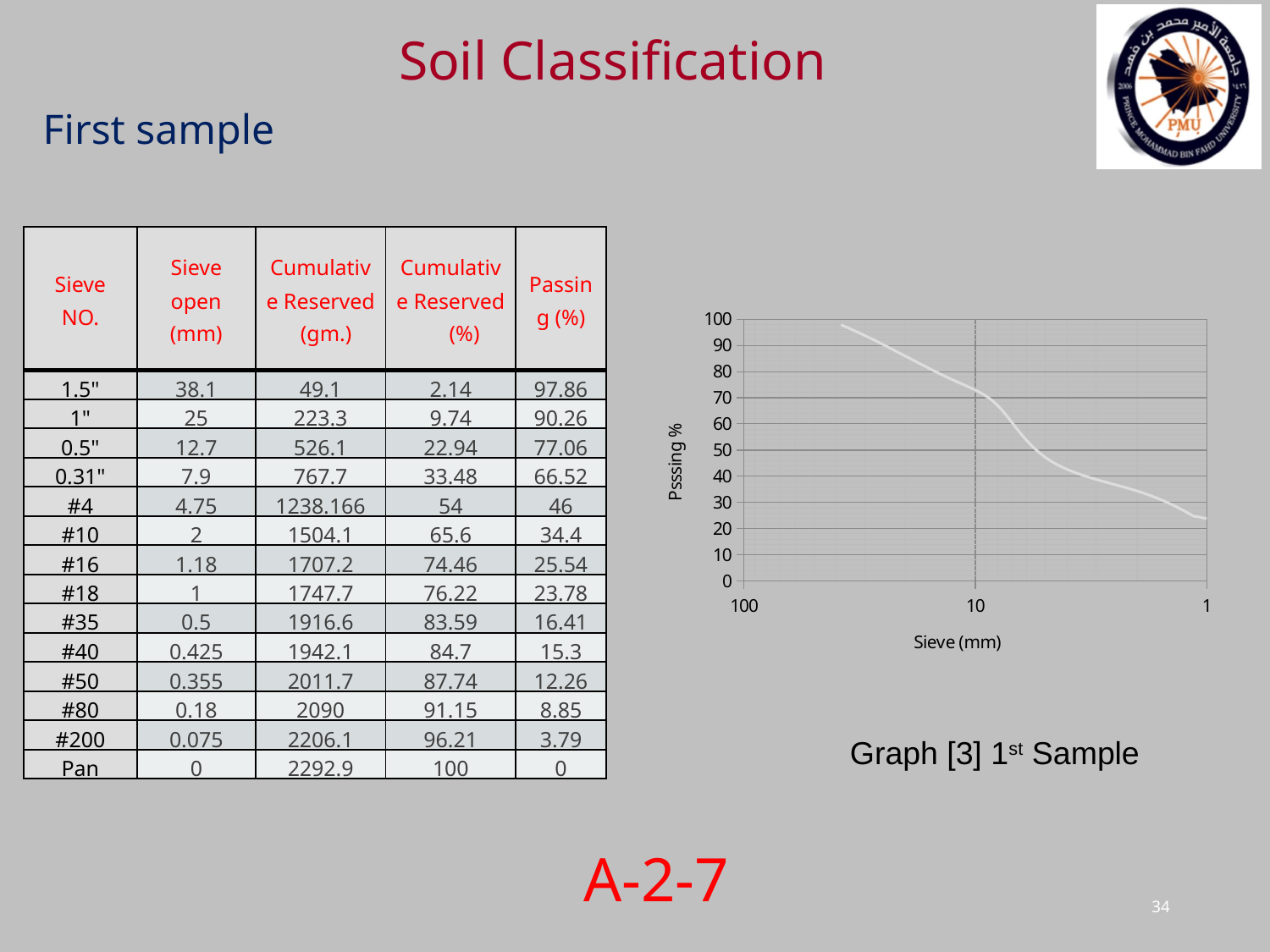
What is the title of the y axis of the chart? Psssing % Moving from left to right along the x axis, do the plotted values rise or fall? fall Is the plotted value at a sieve size of 10 mm greater or less than 60? greater Is the plotted value at a sieve size of 1 mm greater or less than 30? less What kind of chart is shown on the slide? line chart How many tick labels are shown on the x axis? 3 What is the highest tick value shown on the y axis? 100 What is the title of the x axis of the chart? Sieve (mm) Is the plotted value at a sieve size of 10 mm greater or less than 80? less